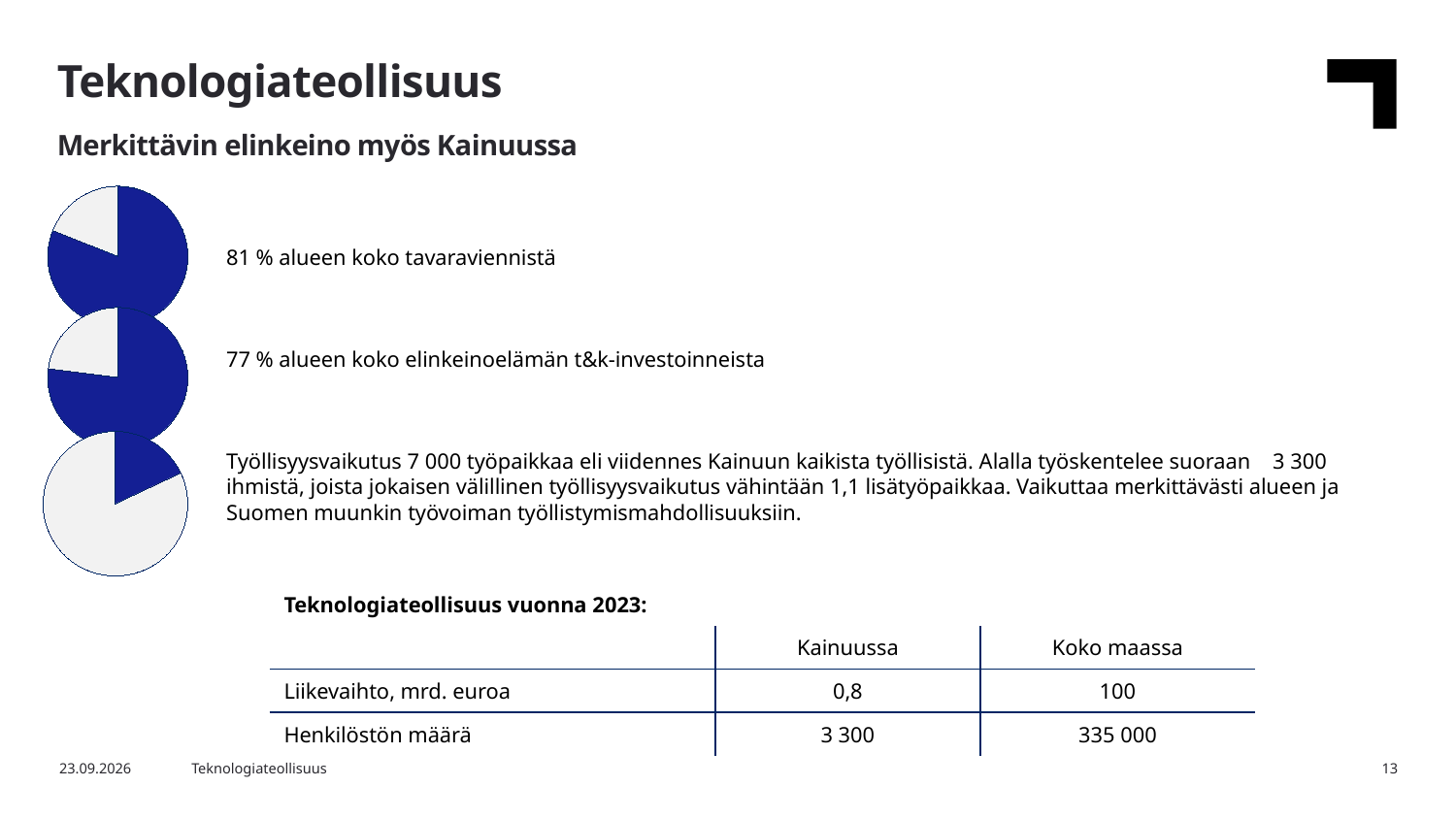
Which pie chart has the largest dark blue slice: the top, middle or bottom one? Top How many pie charts are on the slide? 3 What is the difference between the share shown by the top pie chart (81 %) and the share shown by the middle pie chart (77 %)? 4 percentage points What does the top pie chart illustrate, according to the text next to it? 81 % alueen koko tavaraviennistä What two colours are used for the slices in the pie charts? Dark blue and light grey Is the dark blue slice larger in the top pie chart or in the middle pie chart? Top pie chart In the middle pie chart, what share of the region's business R&D investments does the dark blue slice represent? 77 % In the bottom pie chart, is the dark blue slice larger or smaller than the light grey slice? Smaller What kind of charts are shown on the left side of the slide? Pie charts In the top pie chart, what share of the region's total goods exports does the dark blue slice represent? 81 % Which pie chart has the smallest dark blue slice: the top, middle or bottom one? Bottom